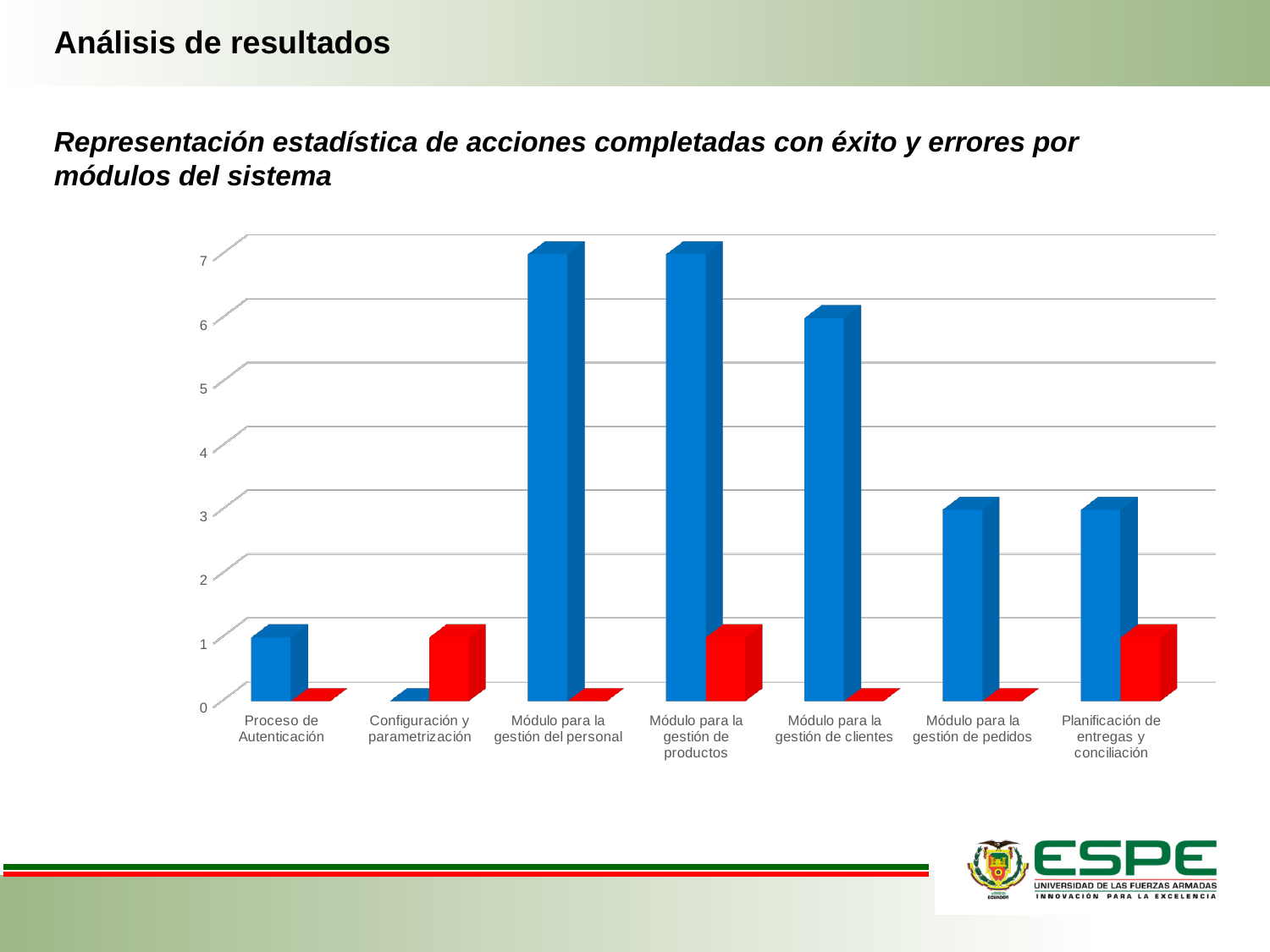
What kind of chart is shown on the slide? bar chart Which category has the lowest blue bar? Configuración y parametrización Is the blue bar for 'Módulo para la gestión de clientes' greater or less than 5? greater What is the value of the blue bar for 'Módulo para la gestión de clientes'? 6 What is the value of the blue bar for 'Proceso de Autenticación'? 1 Is the blue bar for 'Planificación de entregas y conciliación' greater or less than 4? less What is the difference between the blue bar for 'Módulo para la gestión del personal' and the blue bar for 'Módulo para la gestión de pedidos'? 4 How many categories (modules) are shown on the x axis of the chart? 7 What is the value of the blue bar for 'Módulo para la gestión de pedidos'? 3 What is the title text shown above the chart? Representación estadística de acciones completadas con éxito y errores por módulos del sistema Which is larger: the blue bar for 'Módulo para la gestión de clientes' or the blue bar for 'Módulo para la gestión de pedidos'? Módulo para la gestión de clientes What is the value of the red bar for 'Configuración y parametrización'? 1